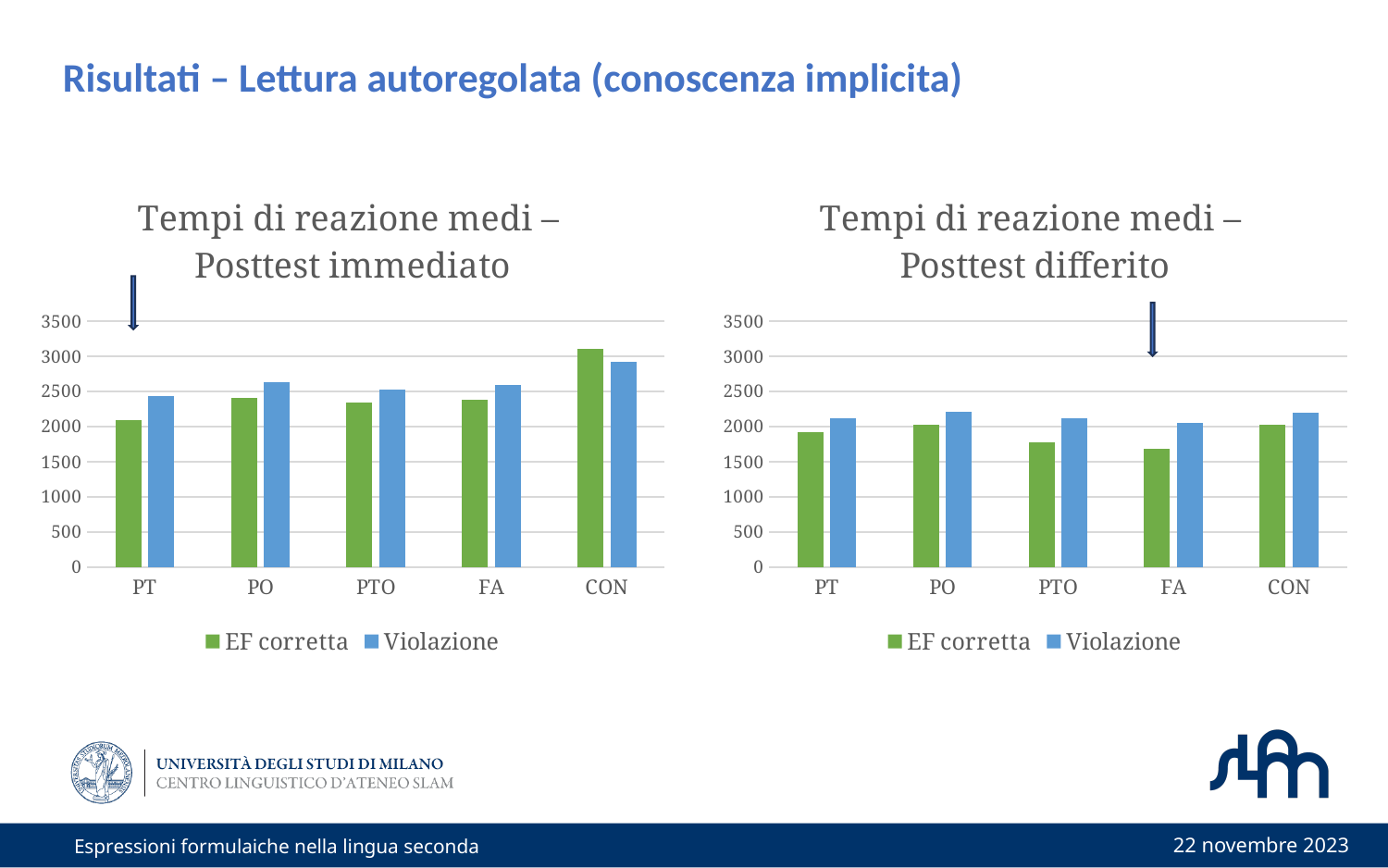
In the chart titled "Tempi di reazione medi – Posttest immediato", which category has the highest EF corretta value? CON In the chart titled "Tempi di reazione medi – Posttest differito", what are the two legend entries? EF corretta and Violazione In the chart titled "Tempi di reazione medi – Posttest differito", is the EF corretta value for FA greater or less than 2000? less Which chart shows the larger EF corretta value for CON: the left chart (Posttest immediato) or the right chart (Posttest differito)? the left chart (Posttest immediato) In the chart titled "Tempi di reazione medi – Posttest immediato", for PT, which is larger: EF corretta or Violazione? Violazione In the chart titled "Tempi di reazione medi – Posttest immediato", is the EF corretta value for CON greater or less than 3000? greater In the chart titled "Tempi di reazione medi – Posttest immediato", which category has the lowest EF corretta value? PT In the chart titled "Tempi di reazione medi – Posttest immediato", is the Violazione value for PO greater or less than 2500? greater In the chart titled "Tempi di reazione medi – Posttest immediato", which category has the highest Violazione value? CON In the chart titled "Tempi di reazione medi – Posttest differito", how many series does the legend list? 2 In the chart titled "Tempi di reazione medi – Posttest immediato", what kind of chart is shown? bar chart In the chart titled "Tempi di reazione medi – Posttest immediato", how many categories are shown on the x axis? 5